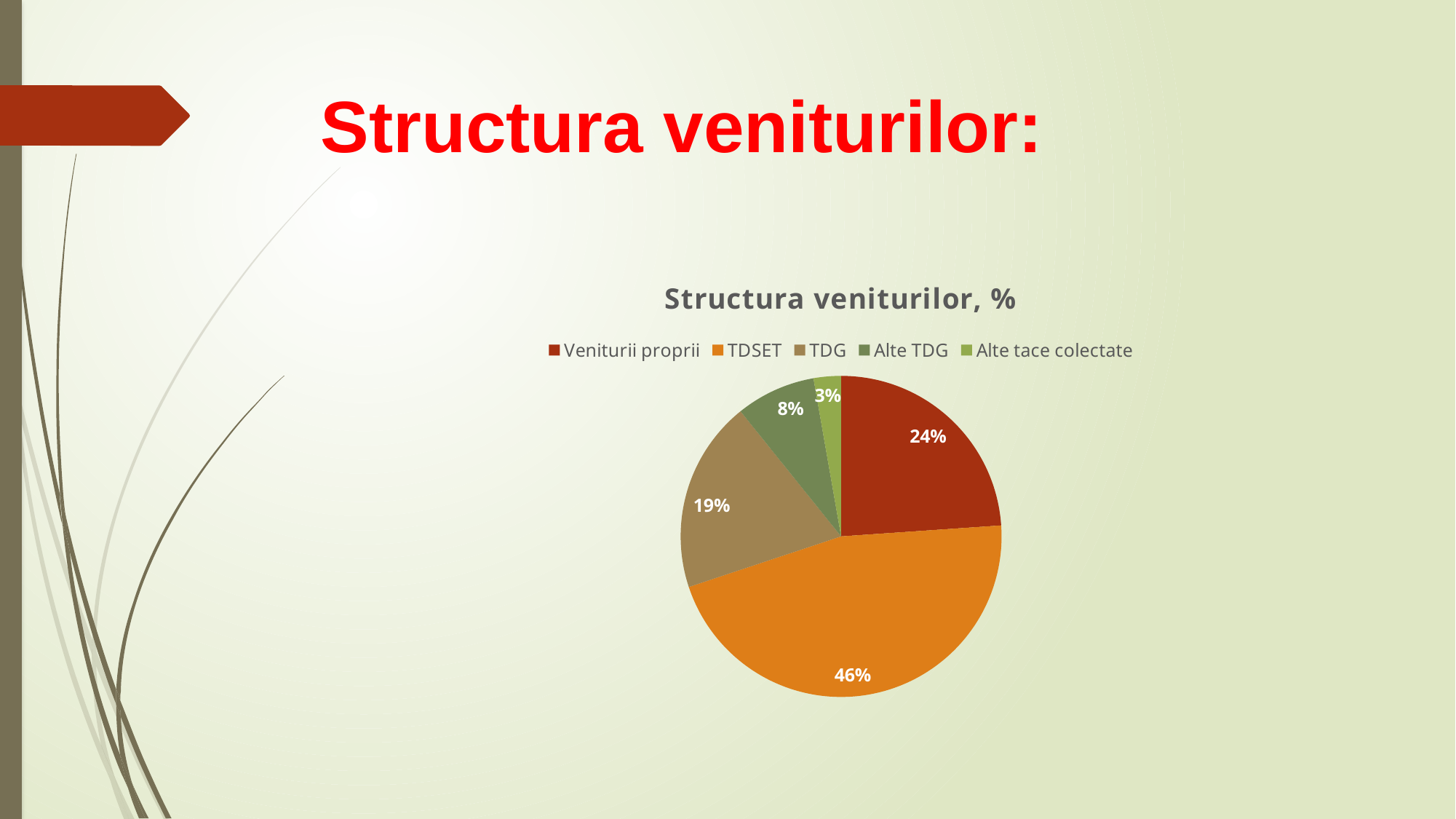
Which category has the smallest share of the pie? Alte tace colectate What is the difference between the shares of TDSET and Veniturii proprii? 22% What is the title of the chart? Structura veniturilor, % What is the value for Veniturii proprii? 24% What is the value for Alte tace colectate? 3% What type of chart is shown on the slide? pie chart What is the value for TDG? 19% How many categories does the legend list? 5 What is the value for Alte TDG? 8% What share of the pie does TDSET represent? 46% Which is larger, the share for TDG or the share for Alte TDG? TDG Which category has the largest share of the pie? TDSET